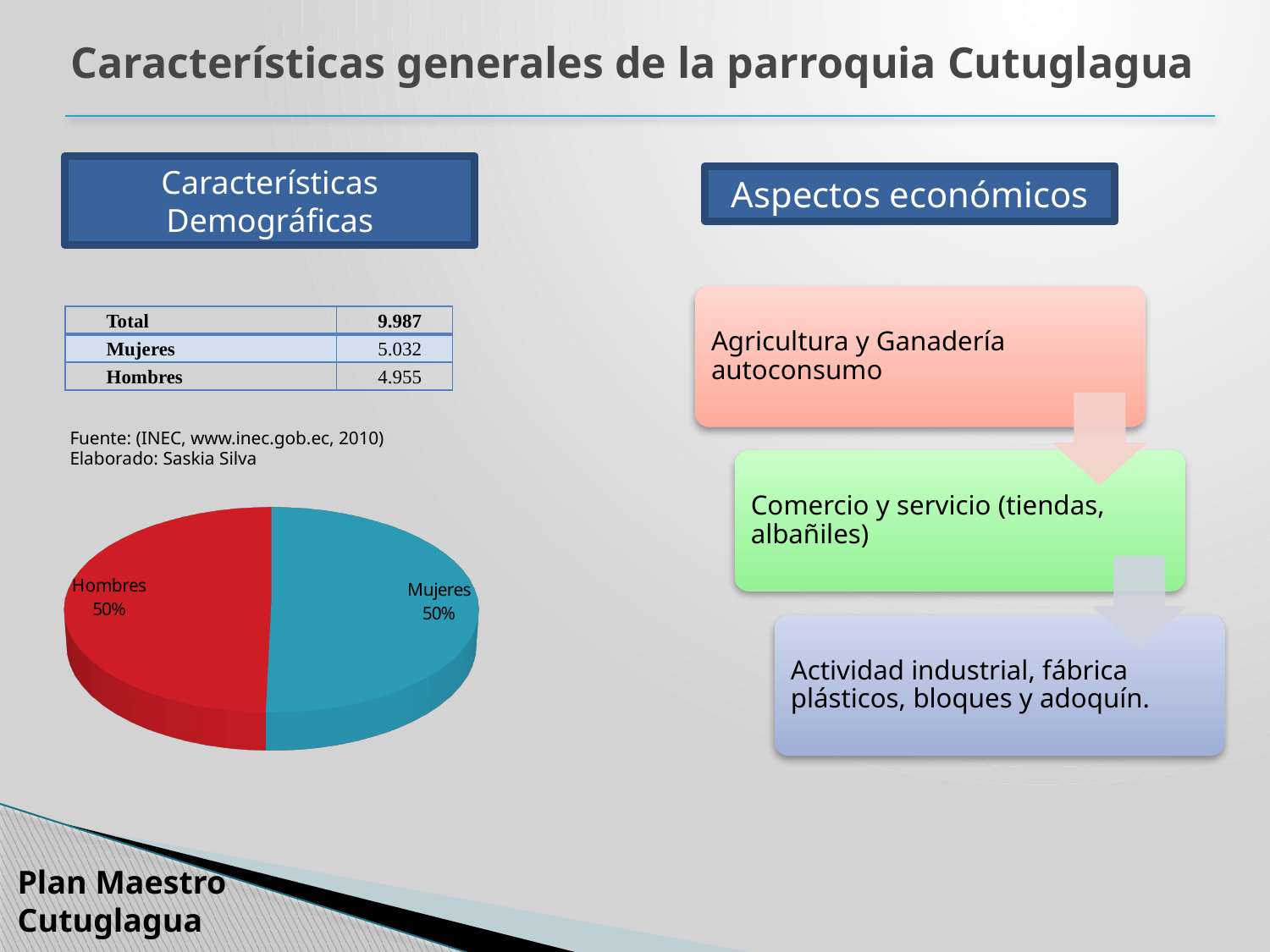
What share of the pie does the Hombres slice represent? 50% What percentage does the pie chart show for Mujeres? 50% What colour is the Hombres slice in the pie chart? red What percentage does the pie chart show for Hombres? 50% What kind of chart is shown on the slide? pie chart What share of the pie does the Mujeres slice represent? 50% What are the labels of the two slices in the pie chart? Hombres and Mujeres How many slices does the pie chart have? 2 What colour is the Mujeres slice in the pie chart? blue